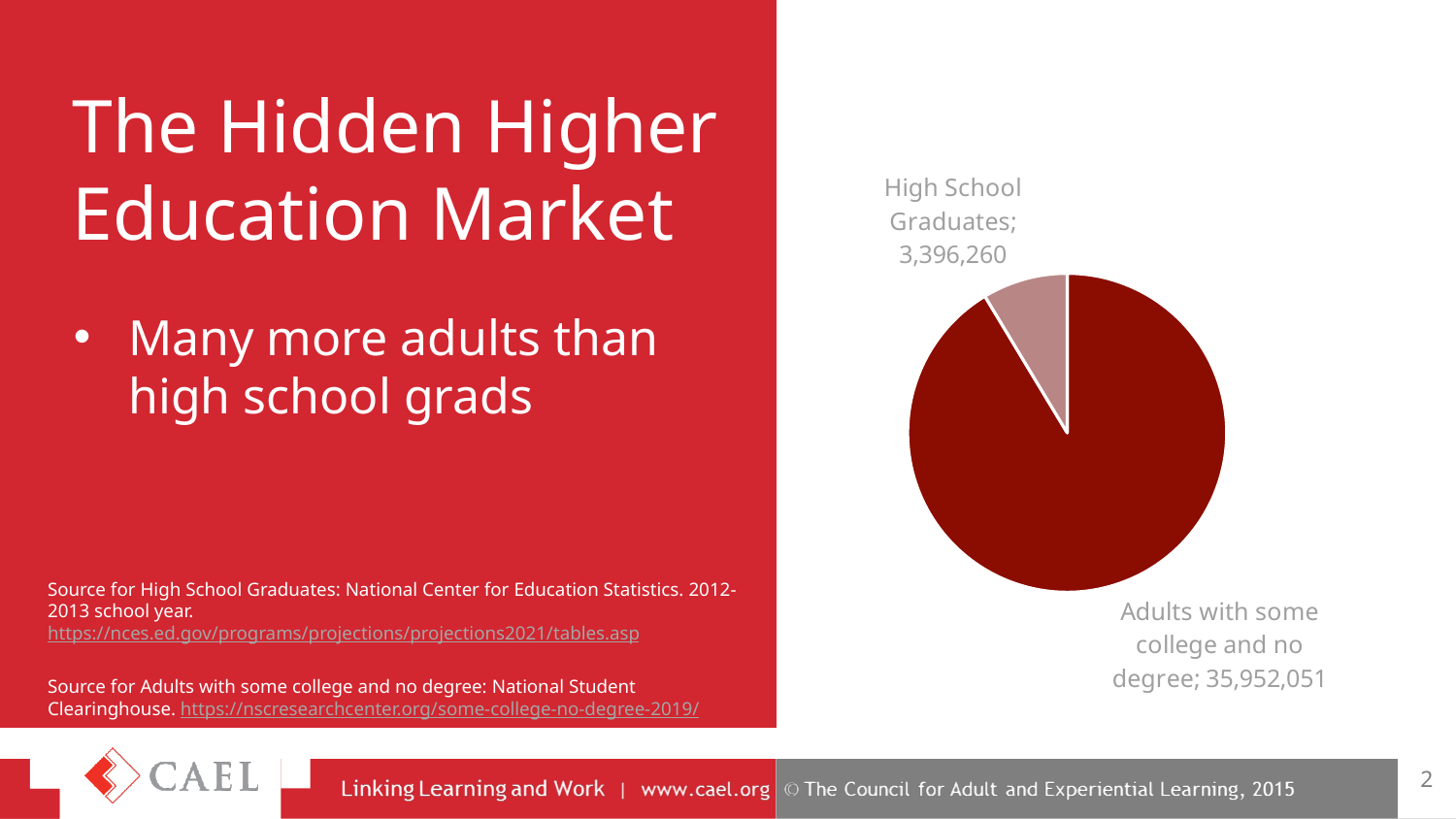
Which slice of the pie chart is shown in the lighter pink colour? High School Graduates Which is larger: the value for High School Graduates or the value for Adults with some college and no degree? Adults with some college and no degree How many slices does the pie chart have? 2 Which category has the smallest slice in the pie chart? High School Graduates What is the value for Adults with some college and no degree in the pie chart? 35,952,051 What is the total of the two values shown in the pie chart? 39,348,311 Which category has the largest slice in the pie chart? Adults with some college and no degree What is the value for High School Graduates in the pie chart? 3,396,260 What is the title of the slide containing the pie chart? The Hidden Higher Education Market What type of chart is shown on the slide? pie chart What is the difference between the value for Adults with some college and no degree and the value for High School Graduates? 32,555,791